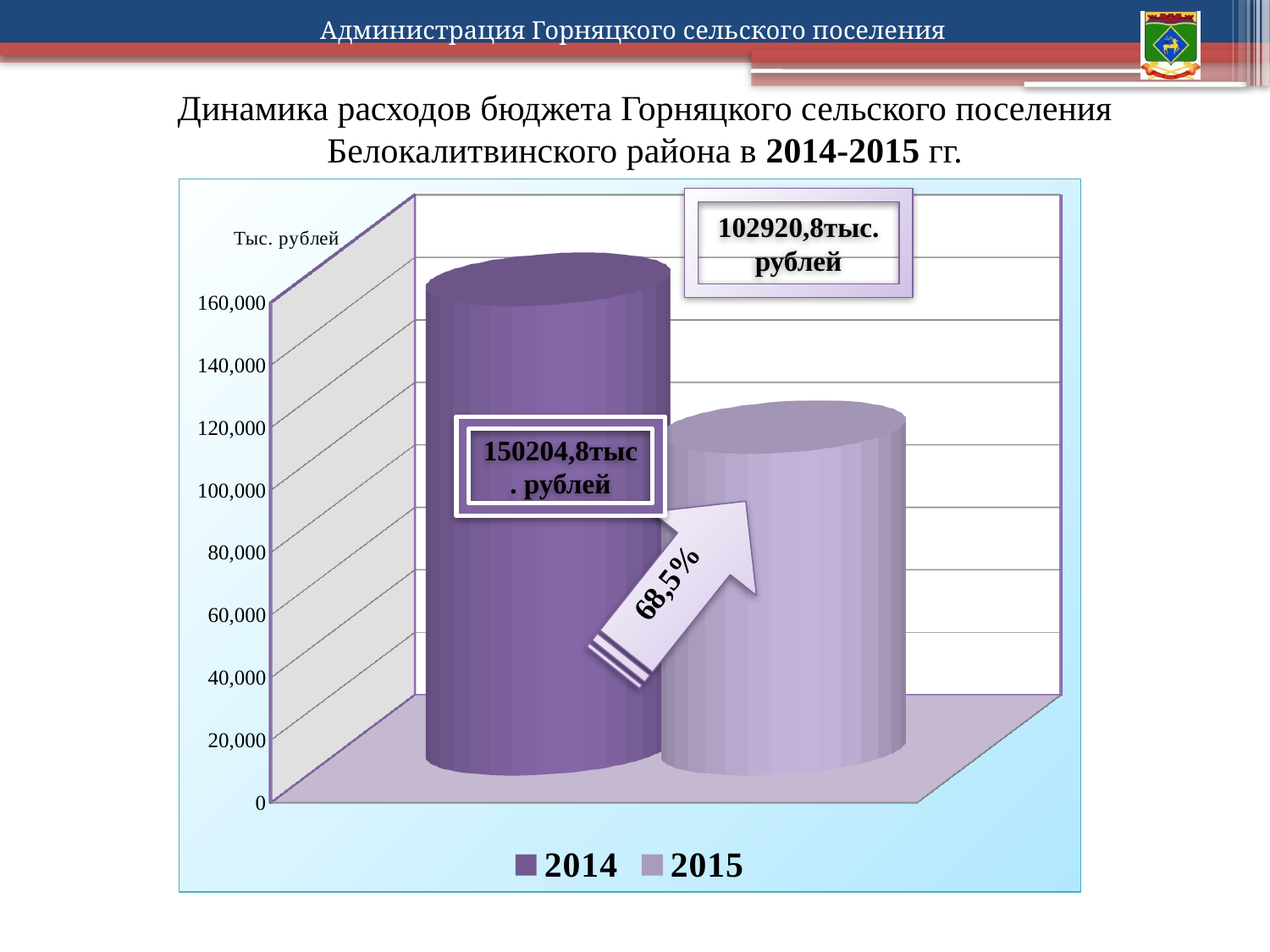
Do the values rise or fall from 2014 to 2015? fall Which year has the higher budget expenditure value? 2014 What kind of chart is shown on the slide? bar chart Is the value for 2014 greater or less than 140,000? greater Is the value for 2014 larger or smaller than the value for 2015? larger How many series does the legend list? 2 What is the value for 2014 on the chart? 150204,8 тыс. рублей Which year has the lower budget expenditure value? 2015 Is the value for 2015 greater or less than 120,000? less What percentage is written on the arrow between the two bars? 68,5% What is the value for 2015 on the chart? 102920,8 тыс. рублей What is the difference between the 2014 and 2015 values? 47284,0 тыс. рублей